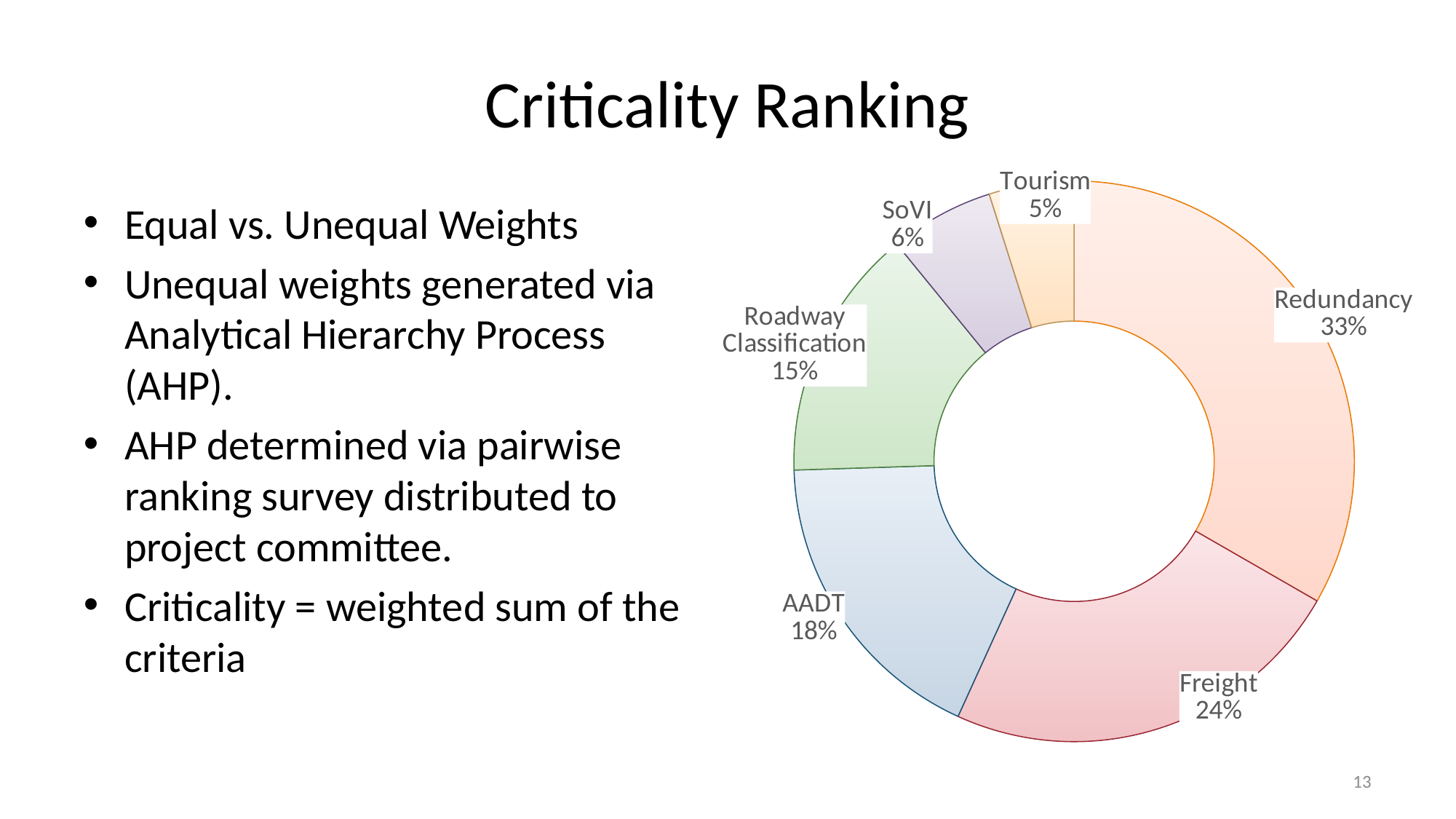
How many categories are shown in the chart? 6 What is the combined share of SoVI and Tourism? 11% What is the difference in percentage points between Redundancy and Freight? 9 What share of the chart does Redundancy account for? 33% Which is larger, AADT or Roadway Classification? AADT What is the value for SoVI? 6% Which category has the smallest share? Tourism Which category has the largest share? Redundancy What kind of chart is shown on the slide? Doughnut chart What percentage is shown for Roadway Classification? 15% What is the value for AADT? 18% What percentage is shown for Freight? 24%